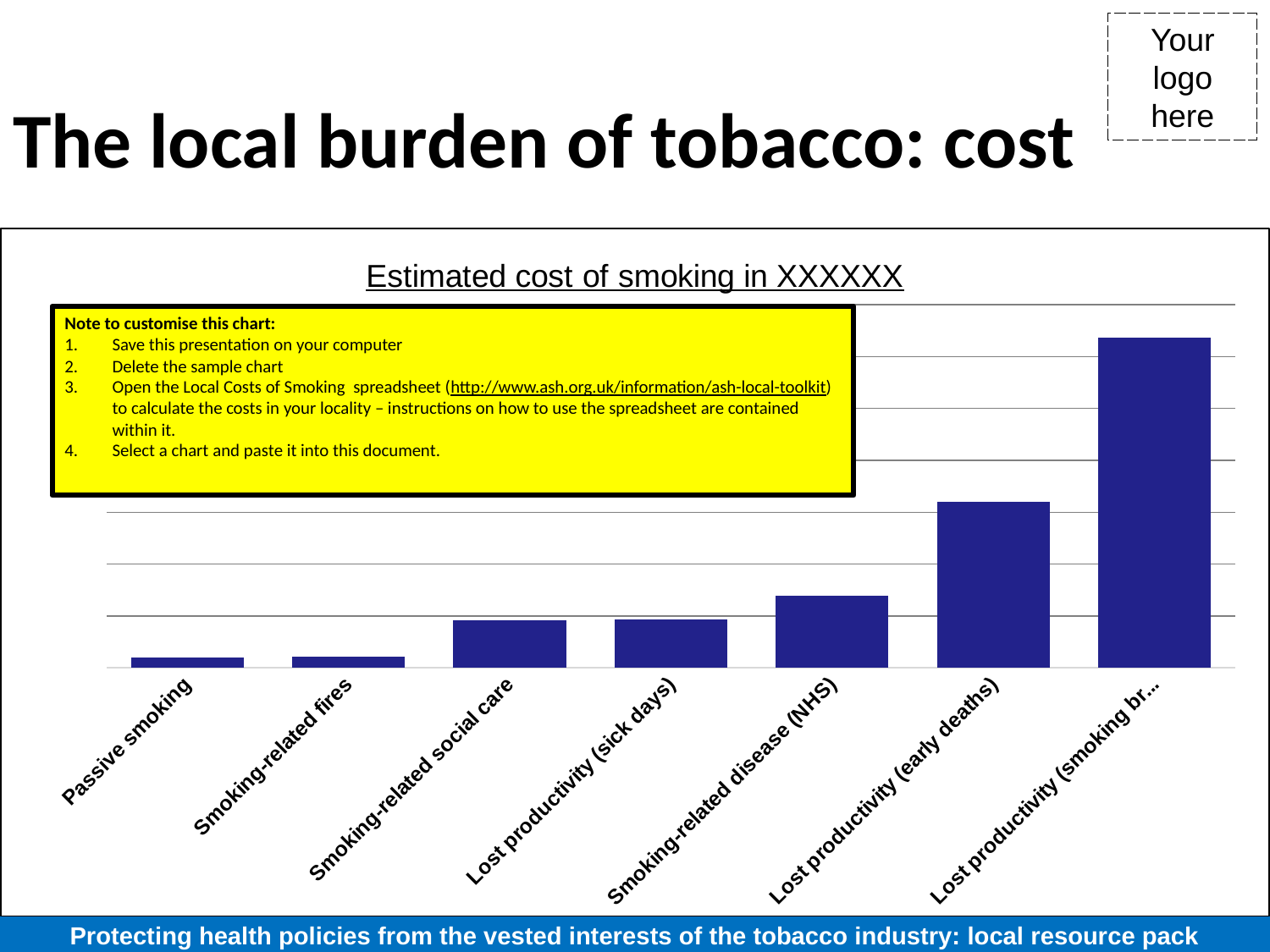
Which bar is the highest in the chart? the rightmost bar, Lost productivity (smoking br...) Which is larger, the bar for Lost productivity (early deaths) or the bar for Smoking-related disease (NHS)? Lost productivity (early deaths) What colour are the bars in the chart? dark blue What is the title of the chart? Estimated cost of smoking in XXXXXX Which is larger, the bar for Lost productivity (sick days) or the bar for Lost productivity (early deaths)? Lost productivity (early deaths) Do the bar values generally rise or fall from left to right along the x axis? rise Which is larger, the bar for Smoking-related social care or the bar for Passive smoking? Smoking-related social care How many categories (bars) does the chart show? 7 What kind of chart is shown on the slide? bar chart